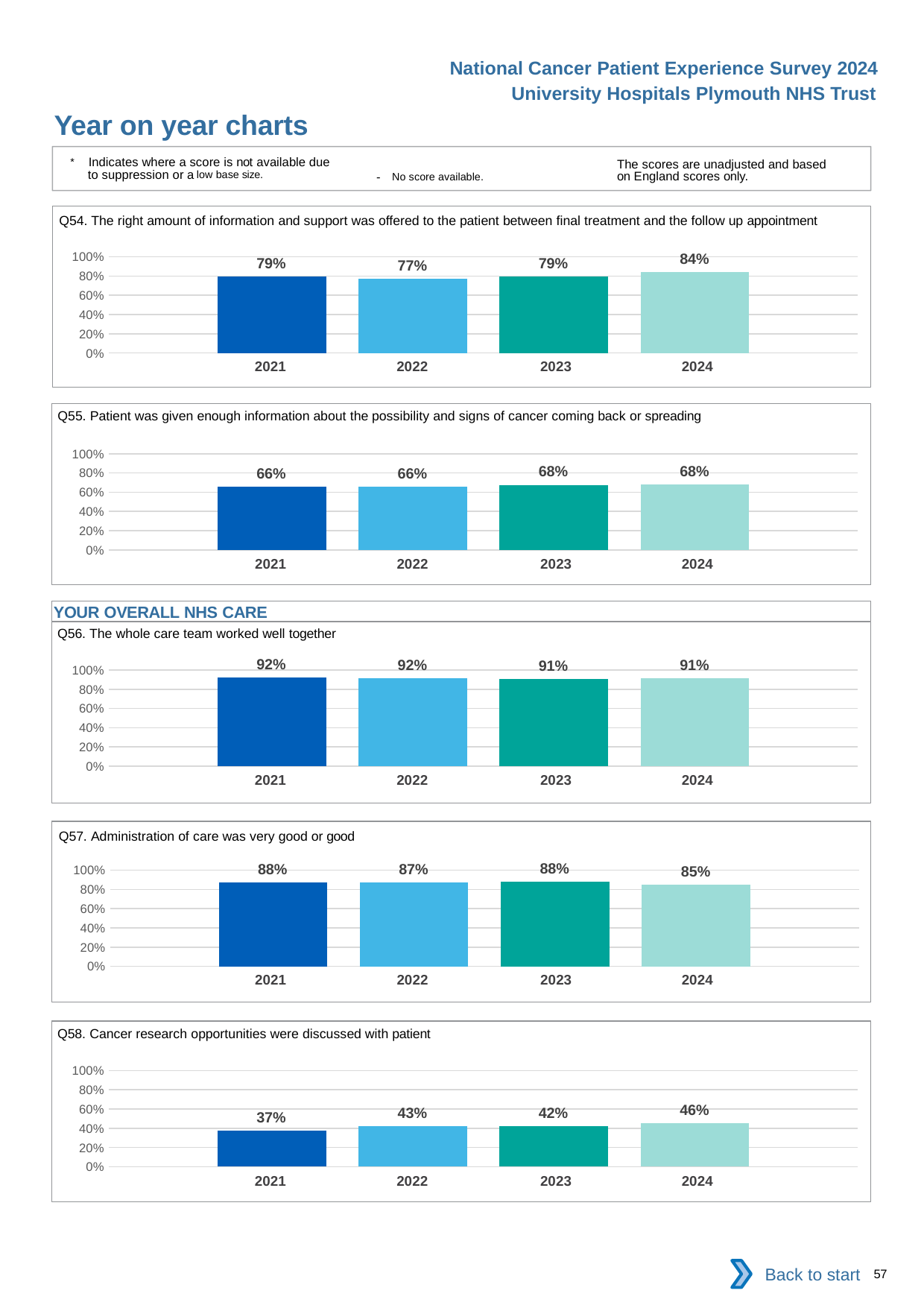
In the Q56 chart, how many years are plotted? 4 In the Q55 chart, what is the value for 2021? 66% In the Q58 chart, which is larger, the value for 2022 or the value for 2021? 2022 In the Q54 chart, which year has the lowest value? 2022 In the Q58 chart, which year has the highest value? 2024 In the Q55 chart, what is the difference between the 2024 value and the 2021 value? 2 percentage points In the Q58 chart, is the value for 2021 greater or less than 40%? less In the Q57 chart, which year has the lowest value? 2024 What kind of chart is the Q54 chart? Bar chart In the Q54 chart, what is the value for 2024? 84% In the Q56 chart, what is the value for 2023? 91% In the Q57 chart, what is the difference between the 2023 value and the 2024 value? 3 percentage points